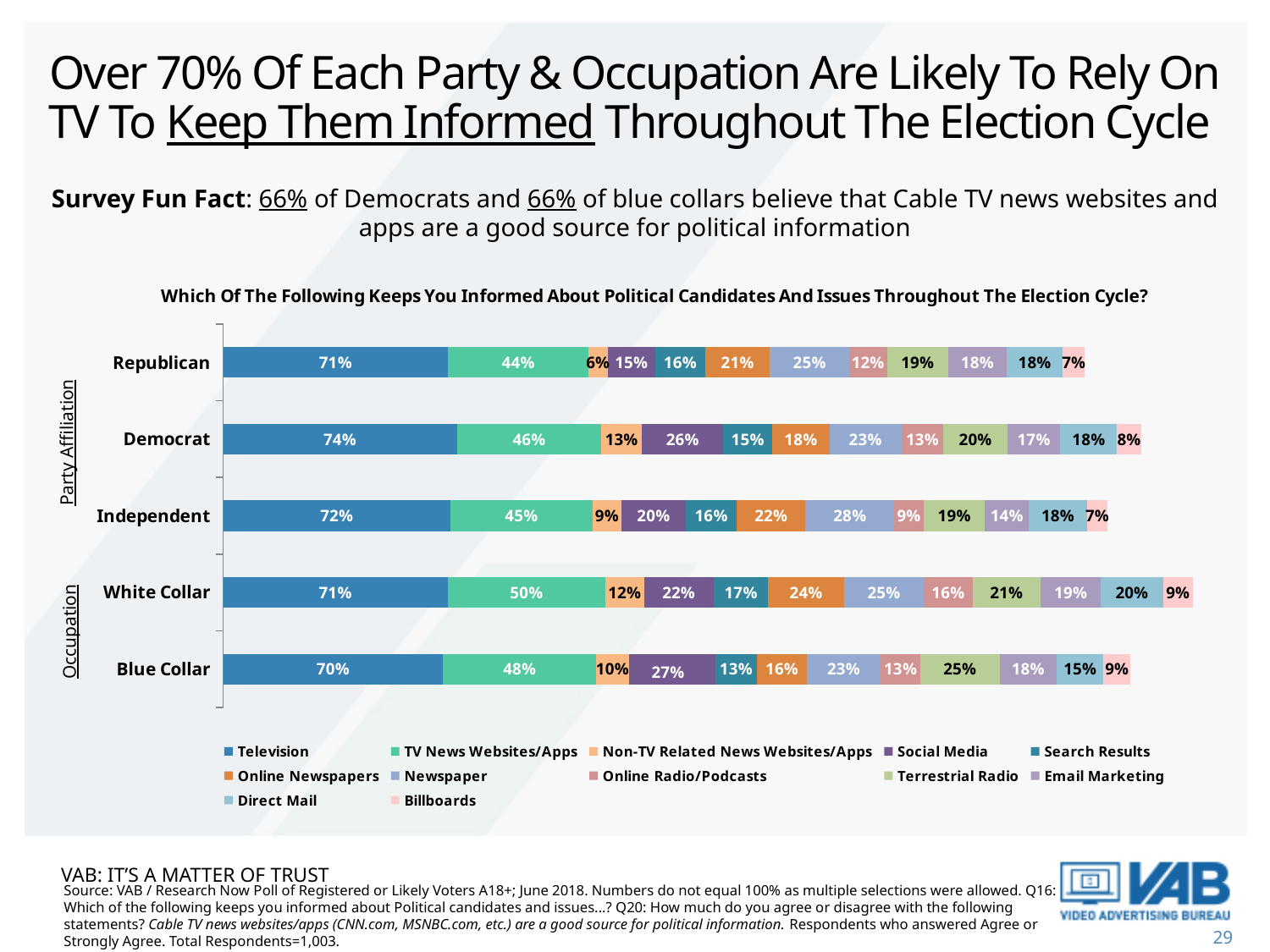
What percentage of Democrats say Television keeps them informed about political candidates and issues? 74% Which is larger, the Social Media value for Democrat or for Republican? Democrat What kind of chart is shown on the slide? Stacked bar chart How many series does the legend list? 12 What is the Social Media value for Blue Collar respondents? 27% What is the Newspaper value for Independents? 28% What is the TV News Websites/Apps value for White Collar respondents? 50% Which series is listed first in the chart legend? Television How many groups (categories) are shown on the chart? 5 What is the difference between the Television values for Democrat and Blue Collar? 4 percentage points Which group has the highest Television value? Democrat Which group has the lowest Television value? Blue Collar